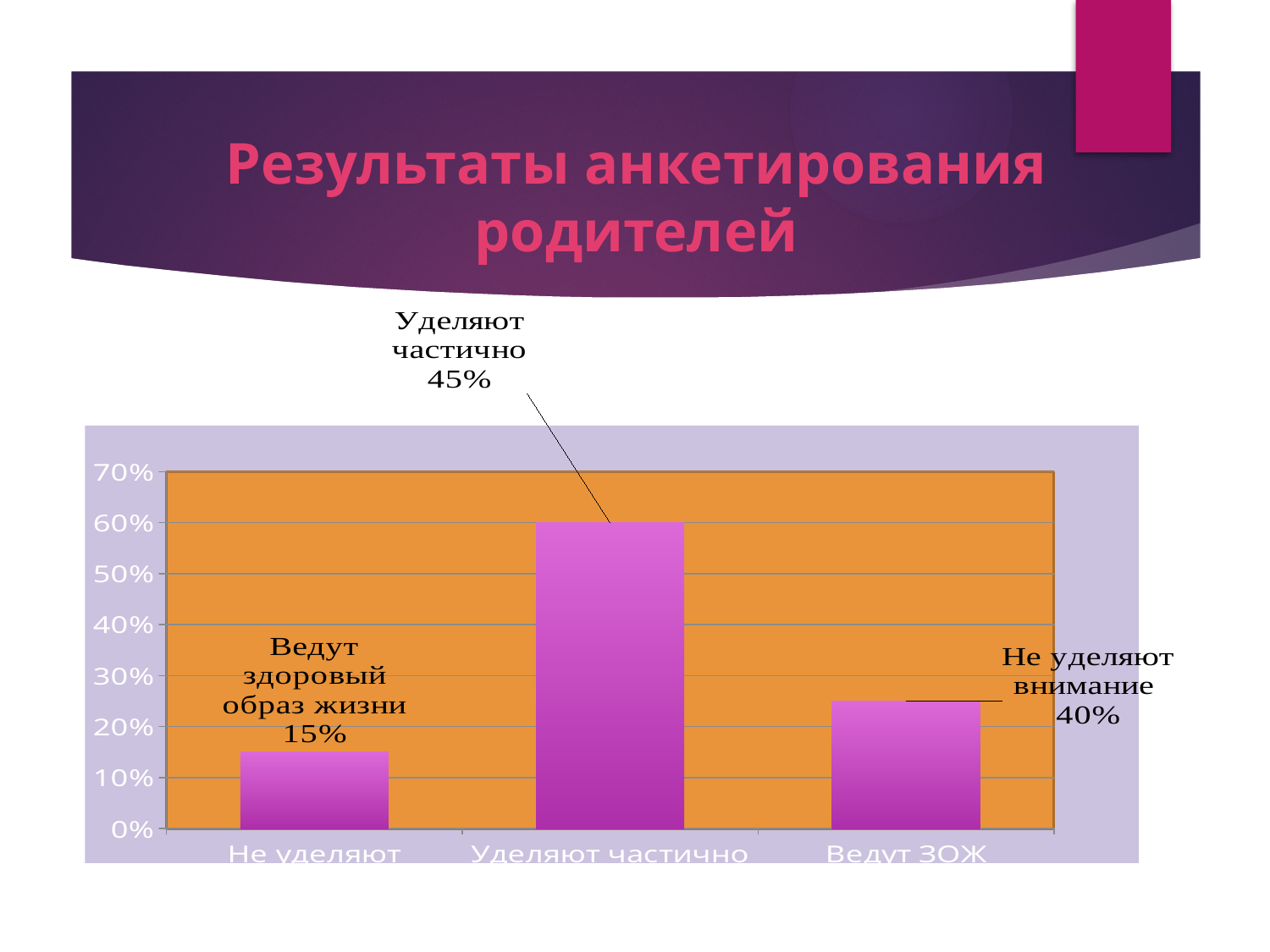
Is the bar for 'Уделяют частично' greater or less than 50%? greater What kind of chart is shown on the slide? bar chart What percentage is printed in the data label that reads 'Уделяют частично'? 45% Which category on the x axis has the tallest bar? Уделяют частично How many bars are plotted in the chart? 3 Which bar is taller, 'Ведут ЗОЖ' or 'Не уделяют'? Ведут ЗОЖ Is the bar for 'Ведут ЗОЖ' greater or less than 30%? less Which category on the x axis has the shortest bar? Не уделяют What is the title of the slide containing the chart? Результаты анкетирования родителей Is the bar for 'Не уделяют' greater or less than 20%? less What is the highest value shown on the vertical axis of the chart? 70% What percentage is printed in the data label that reads 'Не уделяют внимание'? 40%